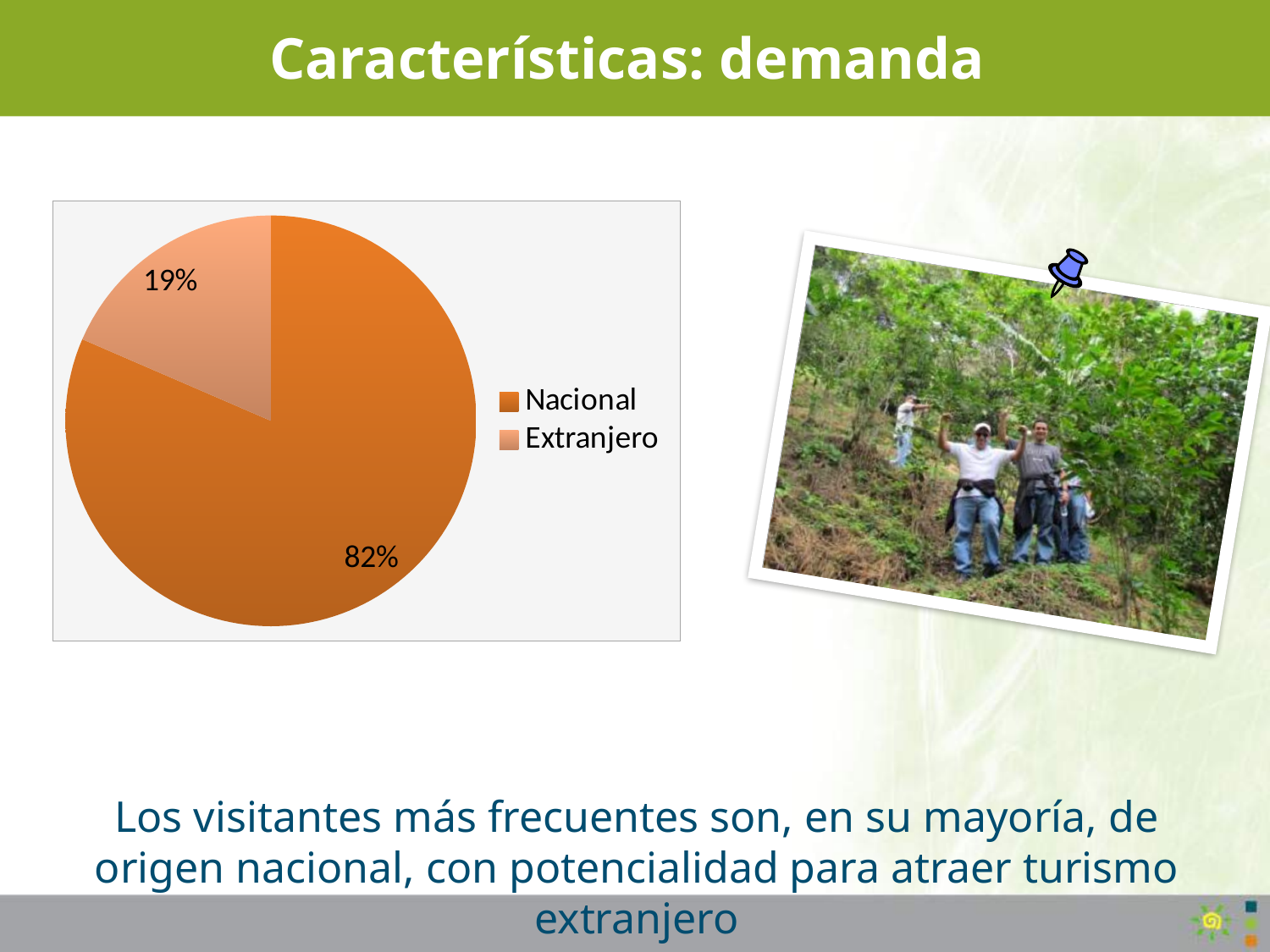
What kind of chart is shown on the slide? pie chart How many entries does the legend of the pie chart list? 2 Which category has the largest slice of the pie chart? Nacional What percentage of the pie chart is labelled Nacional? 82% Which category has the smallest slice of the pie chart? Extranjero What percentage of the pie chart is labelled Extranjero? 19% Which slice of the pie chart is drawn in the darker orange colour? Nacional What is the difference between the Nacional and Extranjero percentages shown on the pie chart? 63 percentage points What are the two legend entries of the pie chart? Nacional and Extranjero Which slice is larger, Nacional or Extranjero? Nacional How many slices does the pie chart have? 2 What share of the pie does the Extranjero slice represent? 19%